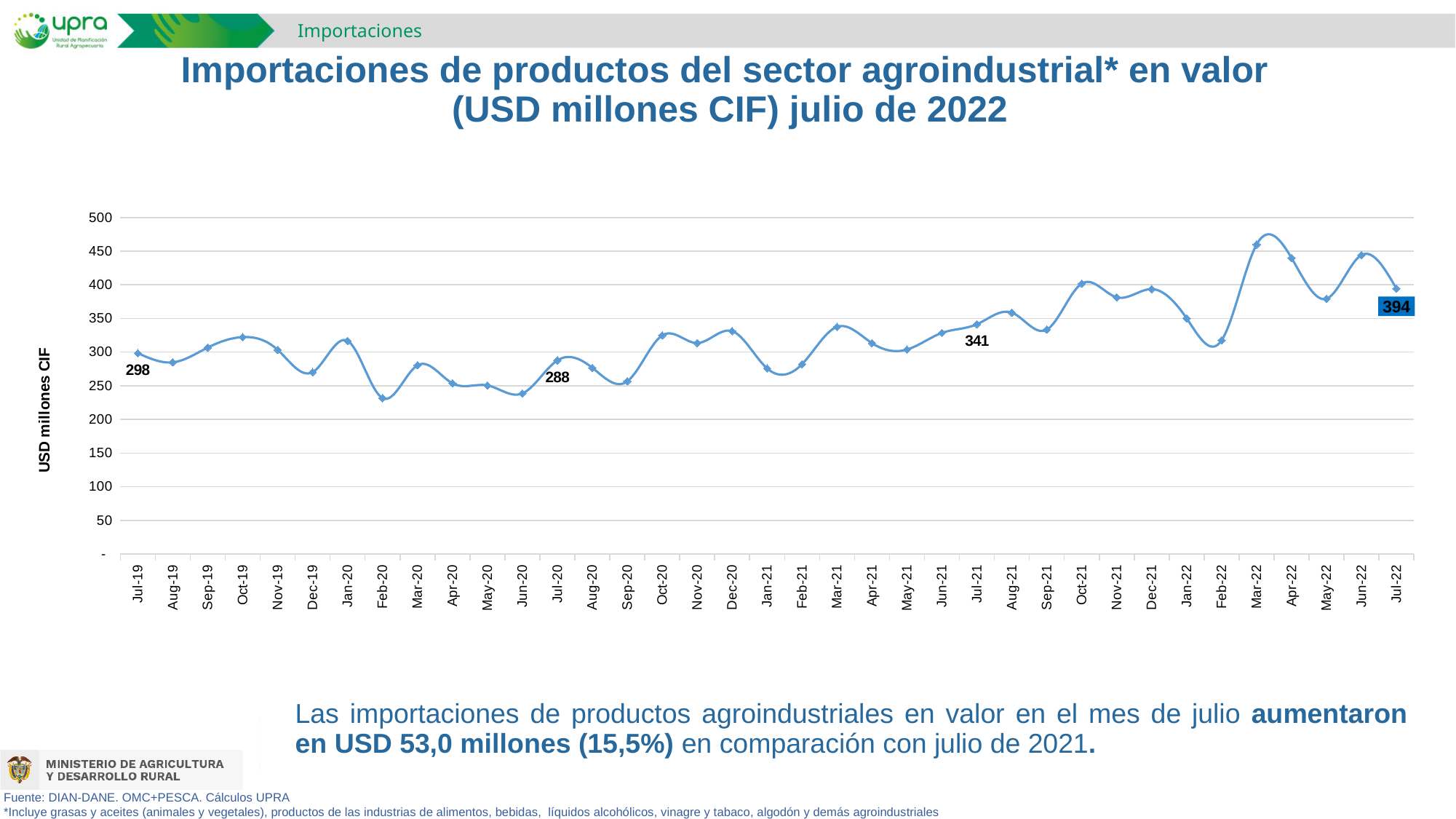
What is the value for Jul-21? 341 What is the value for Jul-20? 288 What is the value for Jul-19? 298 Which is larger, the value for Jul-21 or the value for Jul-20? Jul-21 What is the difference between the values for Jul-19 and Jul-20? 10 What is the value for Jul-22? 394 What kind of chart is shown on the slide? line chart What is the difference between the values for Jul-22 and Jul-21? 53 Which month has the highest value on the chart? Mar-22 Which month has the lowest value on the chart? Feb-20 Is the value for Jun-22 greater or less than 400? greater Is the value for Dec-19 greater or less than 300? less